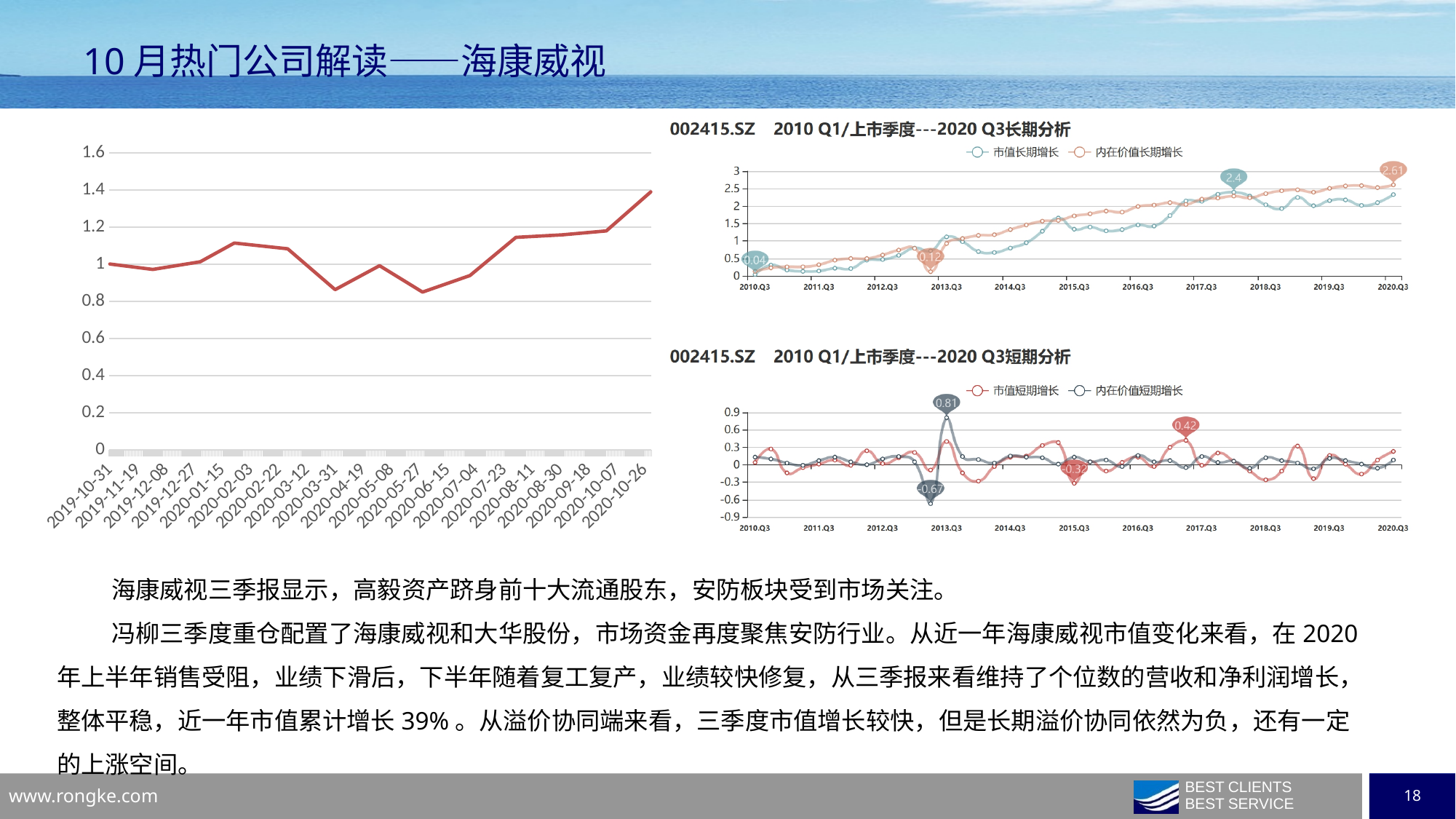
In the chart titled '002415.SZ 2010 Q1/上市季度---2020 Q3短期分析', what is the lowest labelled value of 市值短期增长? -0.32 What kind of chart is the chart on the left of the slide? line chart In the chart titled '002415.SZ 2010 Q1/上市季度---2020 Q3短期分析', what is the highest labelled value of 内在价值短期增长? 0.81 In the chart on the left of the slide, is the value for 2020-10-26 greater or less than 1.2? greater In the chart on the left of the slide, how many dates are shown on the x axis? 20 How many series does the legend list in the chart titled '002415.SZ 2010 Q1/上市季度---2020 Q3长期分析'? 2 In the chart on the left of the slide, which is larger, the value for 2020-02-03 or the value for 2020-06-15? 2020-02-03 In the chart titled '002415.SZ 2010 Q1/上市季度---2020 Q3长期分析', do the values generally rise or fall from 2010.Q3 to 2020.Q3? rise In the chart on the left of the slide, is the value for 2020-03-31 greater or less than 1? less In the chart titled '002415.SZ 2010 Q1/上市季度---2020 Q3长期分析', what is the labelled value of 市值长期增长 at 2010.Q3? 0.04 In the chart titled '002415.SZ 2010 Q1/上市季度---2020 Q3长期分析', what is the labelled value of 内在价值长期增长 at 2020.Q3? 2.61